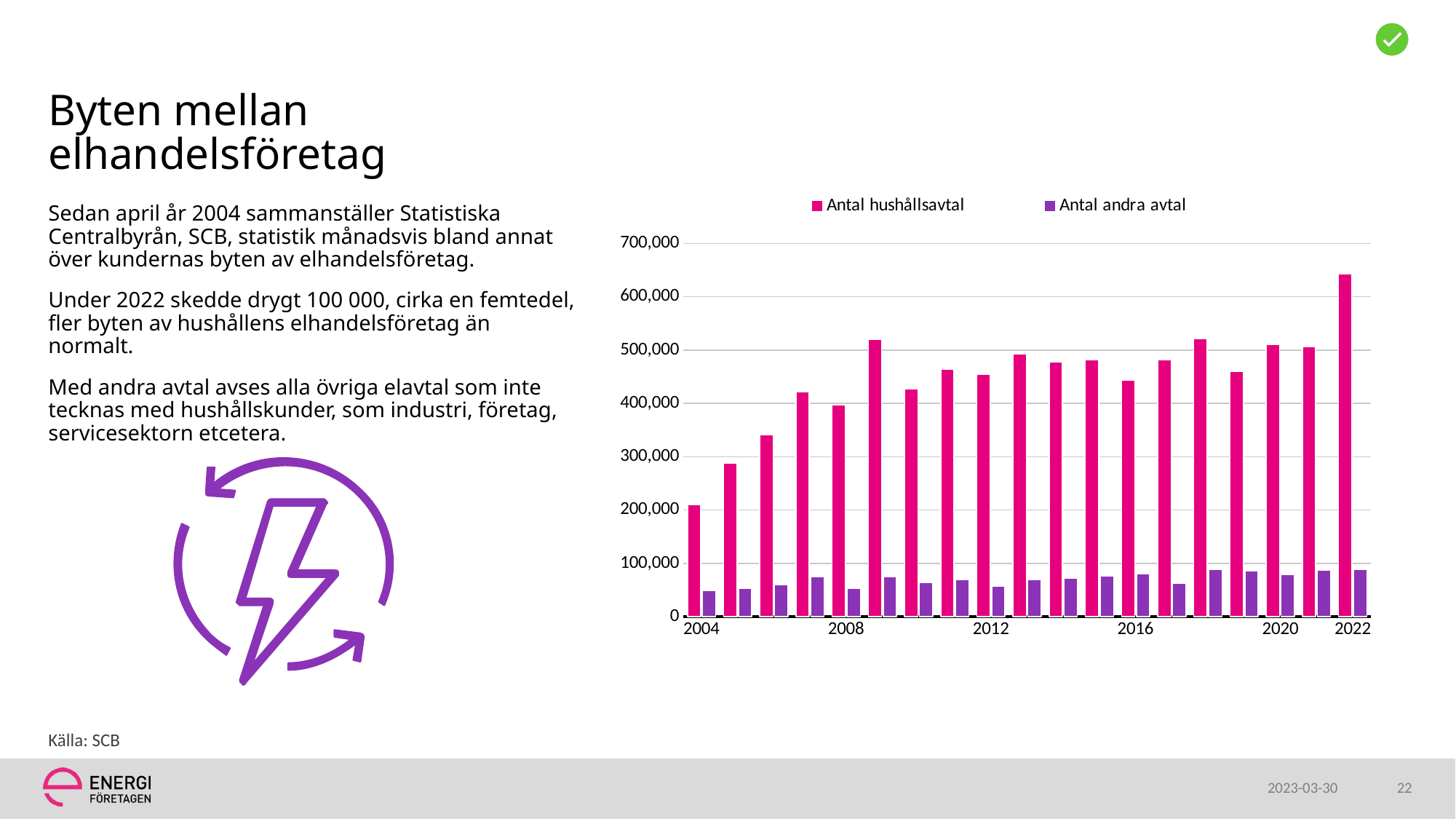
Is the value for Antal hushållsavtal in 2012 greater or less than 400,000? greater Does Antal hushållsavtal rise or fall from 2004 to 2007? rise What kind of chart is shown on the slide? bar chart Is the value for Antal andra avtal in 2022 greater or less than 100,000? less How many series does the chart legend list? 2 Which series has the larger value in 2020, Antal hushållsavtal or Antal andra avtal? Antal hushållsavtal Is the value for Antal hushållsavtal in 2004 greater or less than 300,000? less Which is larger, Antal hushållsavtal in 2004 or in 2022? 2022 Which year has the highest value for Antal hushållsavtal? 2022 What are the two series named in the chart legend? Antal hushållsavtal and Antal andra avtal Which year has the lowest value for Antal hushållsavtal? 2004